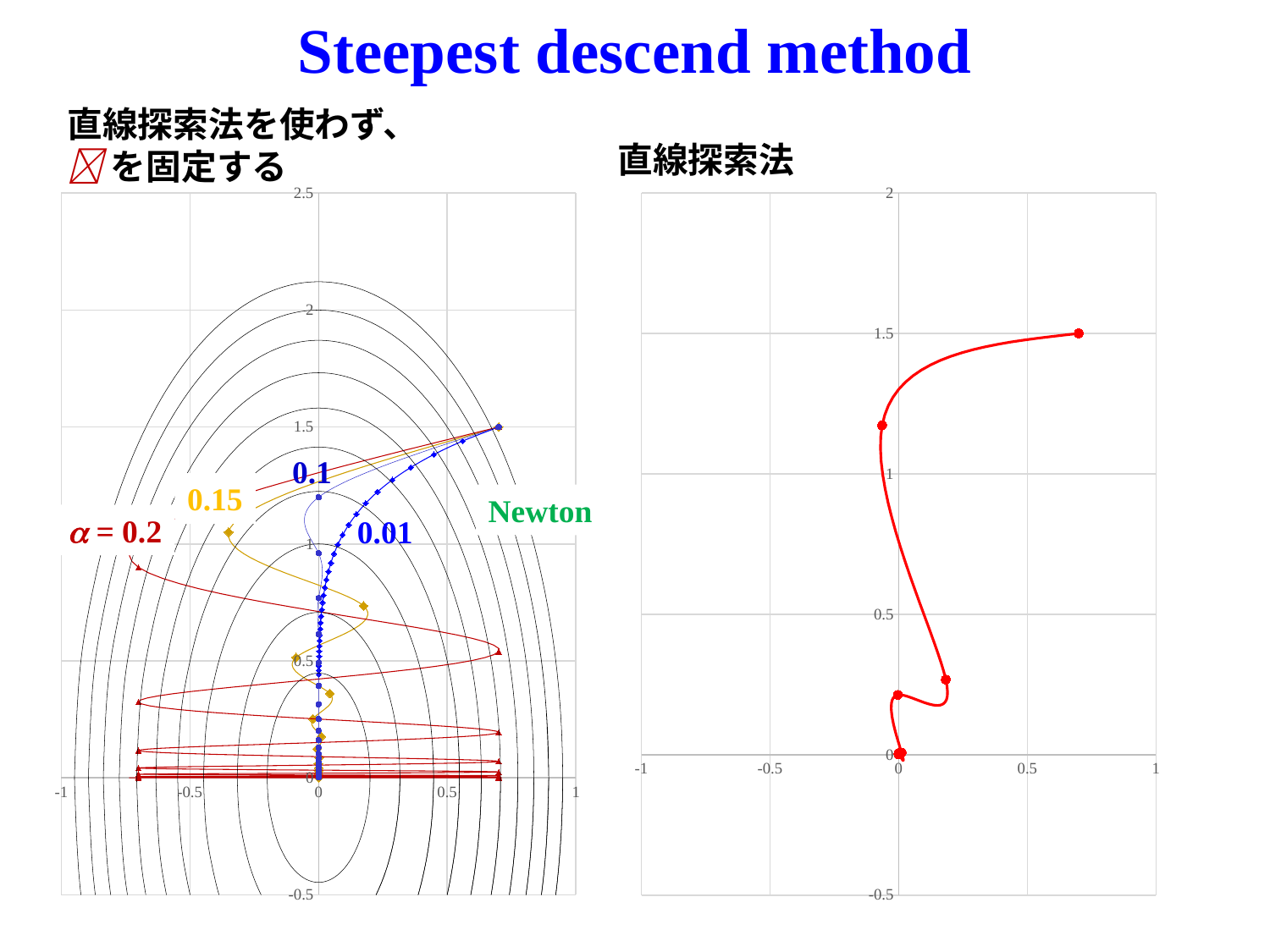
On the left chart, what α value is labelled on the red zigzag trajectory? 0.2 On the right chart (直線探索法), is the y value of the final point of the trajectory greater or less than 0.5? less What is the title of the slide? Steepest descend method On the left chart, what is the highest value shown on the vertical axis? 2.5 On the right chart (直線探索法), is the x value of the starting point (the point at y = 1.5) greater or less than 0.5? greater On the right chart (直線探索法), what is the lowest value shown on the horizontal axis? -1 On the right chart (直線探索法), what is the highest value shown on the vertical axis? 2 On the left chart, is the y value of the common starting point of the trajectories greater or less than 1? greater On the left chart, how many labelled trajectories are drawn (α = 0.2, 0.15, 0.1, 0.01 and Newton)? 5 On the left chart, which labelled trajectory swings widest from side to side across the x axis? α = 0.2 What kind of chart is shown on the left side of the slide? scatter chart On the left chart, what colour is the label 'Newton'? green